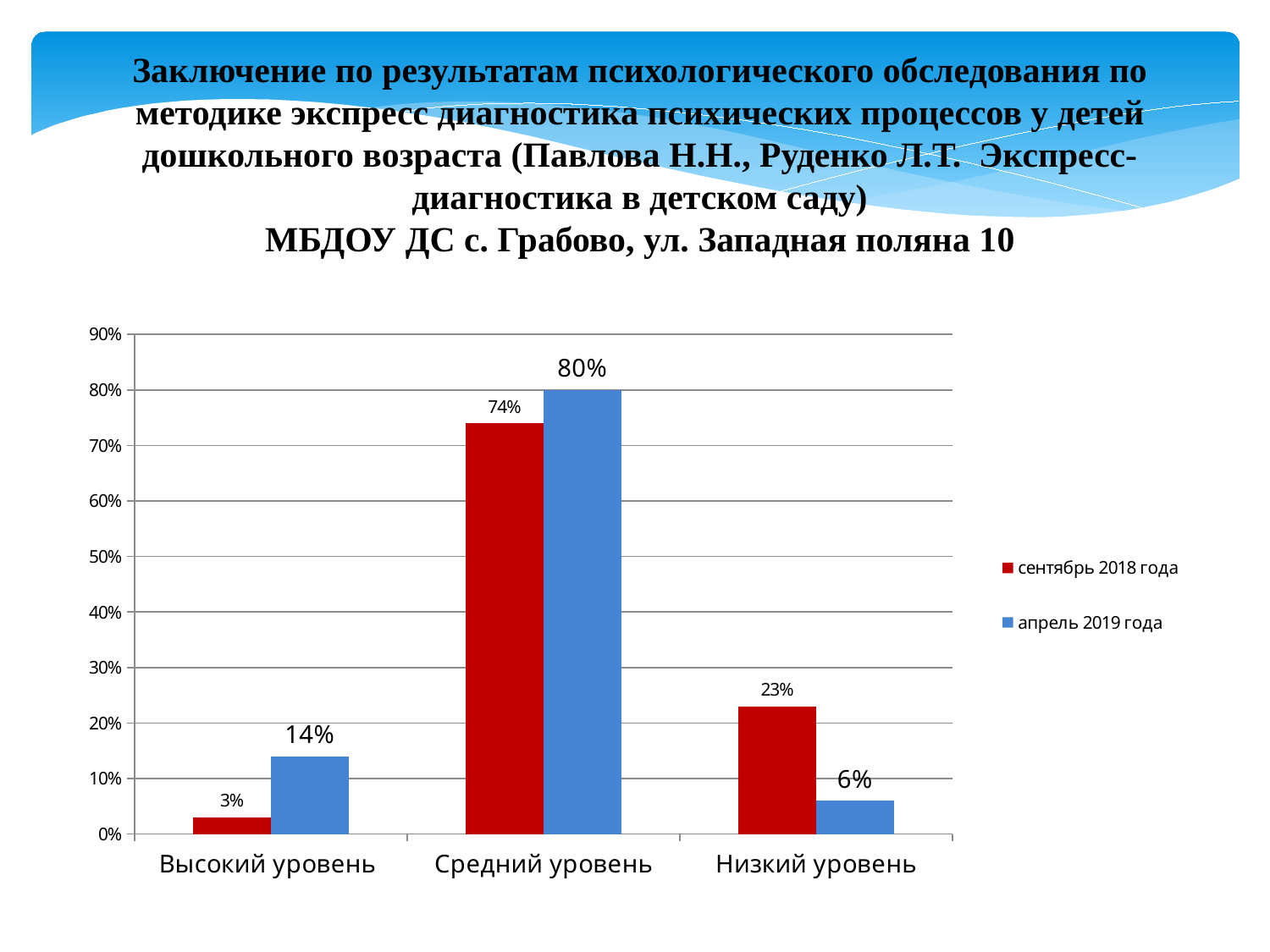
What is the difference between the апрель 2019 года and сентябрь 2018 года values for Средний уровень? 6% What is the value for Средний уровень in апрель 2019 года? 80% Which category has the highest value in сентябрь 2018 года? Средний уровень How many series does the legend list? 2 What is the value for Высокий уровень in апрель 2019 года? 14% What kind of chart is shown on the slide? bar chart Which colour represents апрель 2019 года in the chart? blue What is the value for Высокий уровень in сентябрь 2018 года? 3% Which is larger for Низкий уровень: сентябрь 2018 года or апрель 2019 года? сентябрь 2018 года What is the value for Низкий уровень in сентябрь 2018 года? 23% How many categories are shown on the x axis? 3 Which category has the lowest value in апрель 2019 года? Низкий уровень